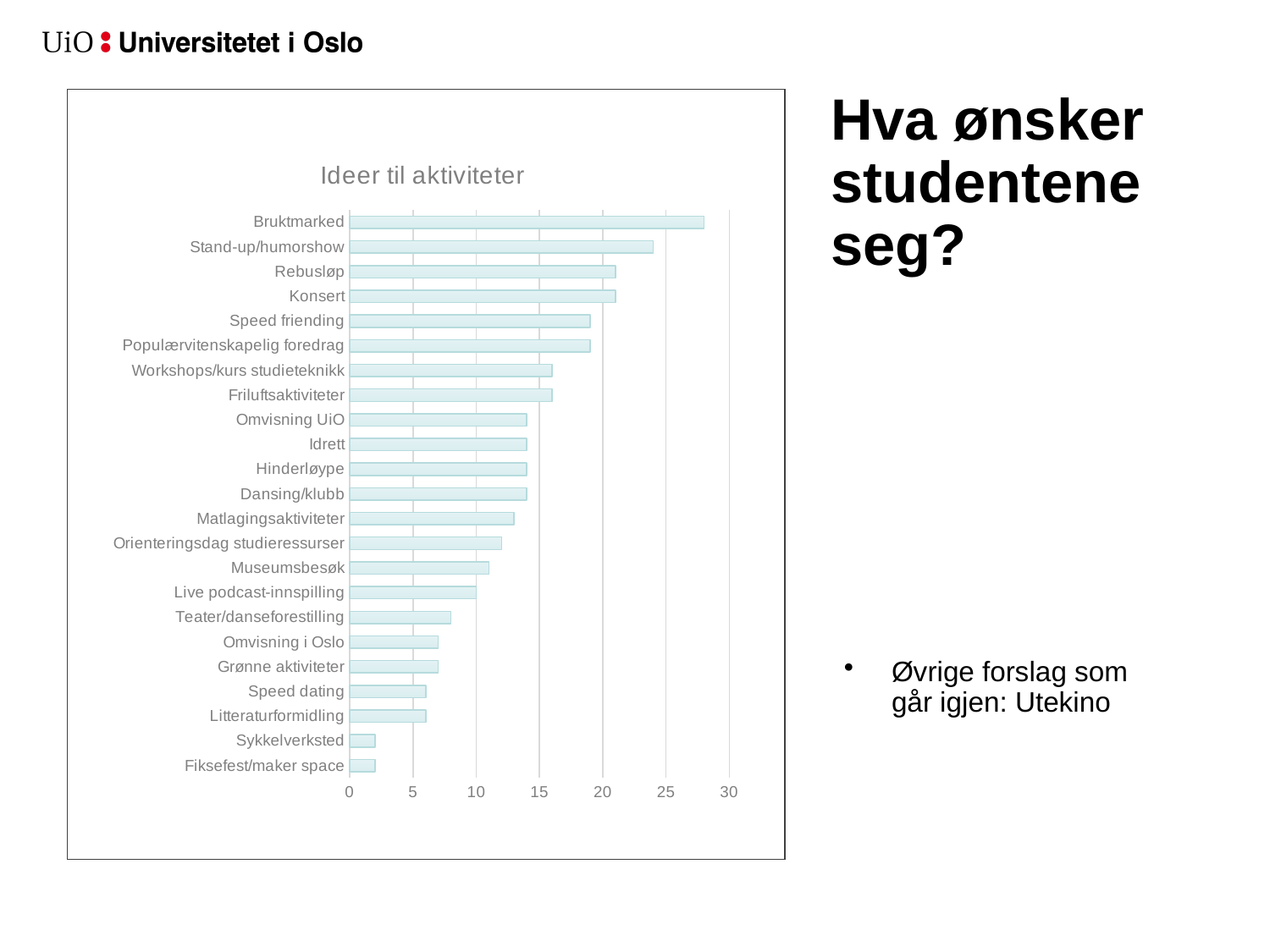
Which activity has the highest value in the chart? Bruktmarked Is the value for Bruktmarked greater or less than 25? greater Which has a larger value, Museumsbesøk or Stand-up/humorshow? Stand-up/humorshow Do the bar values increase or decrease going from the top category to the bottom category? decrease What is the title of the chart? Ideer til aktiviteter Is the value for Matlagingsaktiviteter greater or less than 15? less Is the value for Sykkelverksted greater or less than 5? less What kind of chart is shown on the slide? bar chart Which has a larger value, Bruktmarked or Konsert? Bruktmarked How many activity categories are shown in the chart? 23